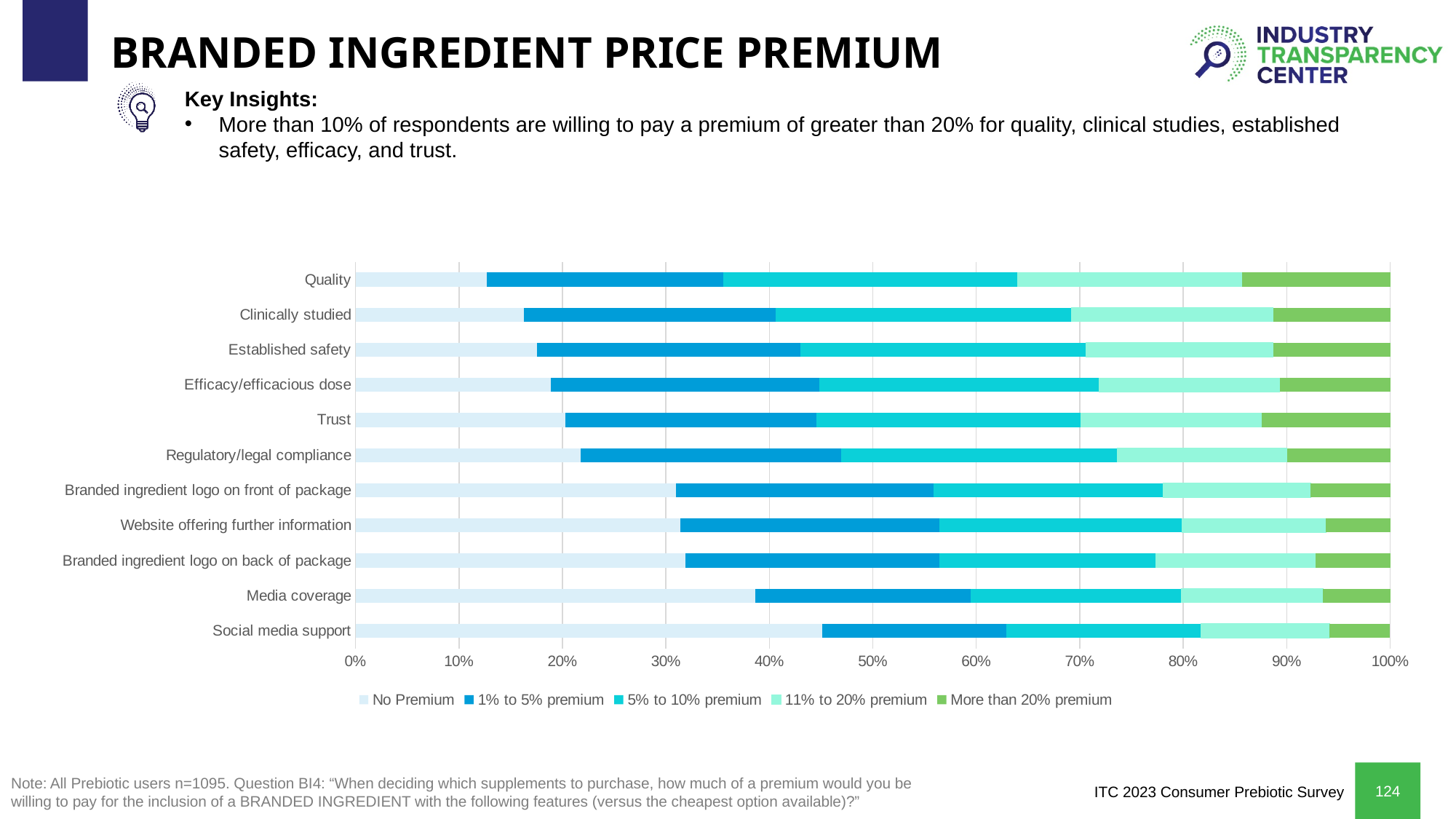
Which category has the smallest 'No Premium' segment? Quality Is the 'No Premium' value for Quality greater or less than 20%? less Is the 'No Premium' value for Social media support greater or less than 40%? greater Which has a larger 'No Premium' segment: Quality or Social media support? Social media support What kind of chart is shown on the slide? Stacked bar chart Which has a larger 'More than 20% premium' segment: Quality or Social media support? Quality How many series does the chart legend list? 5 Is the 'No Premium' value for Clinically studied greater or less than 20%? less Which legend entry is shown in green (the last segment of each bar)? More than 20% premium What does each stacked bar total on the horizontal axis? 100% How many categories (features) are listed on the vertical axis of the chart? 11 Which category has the largest 'No Premium' segment? Social media support